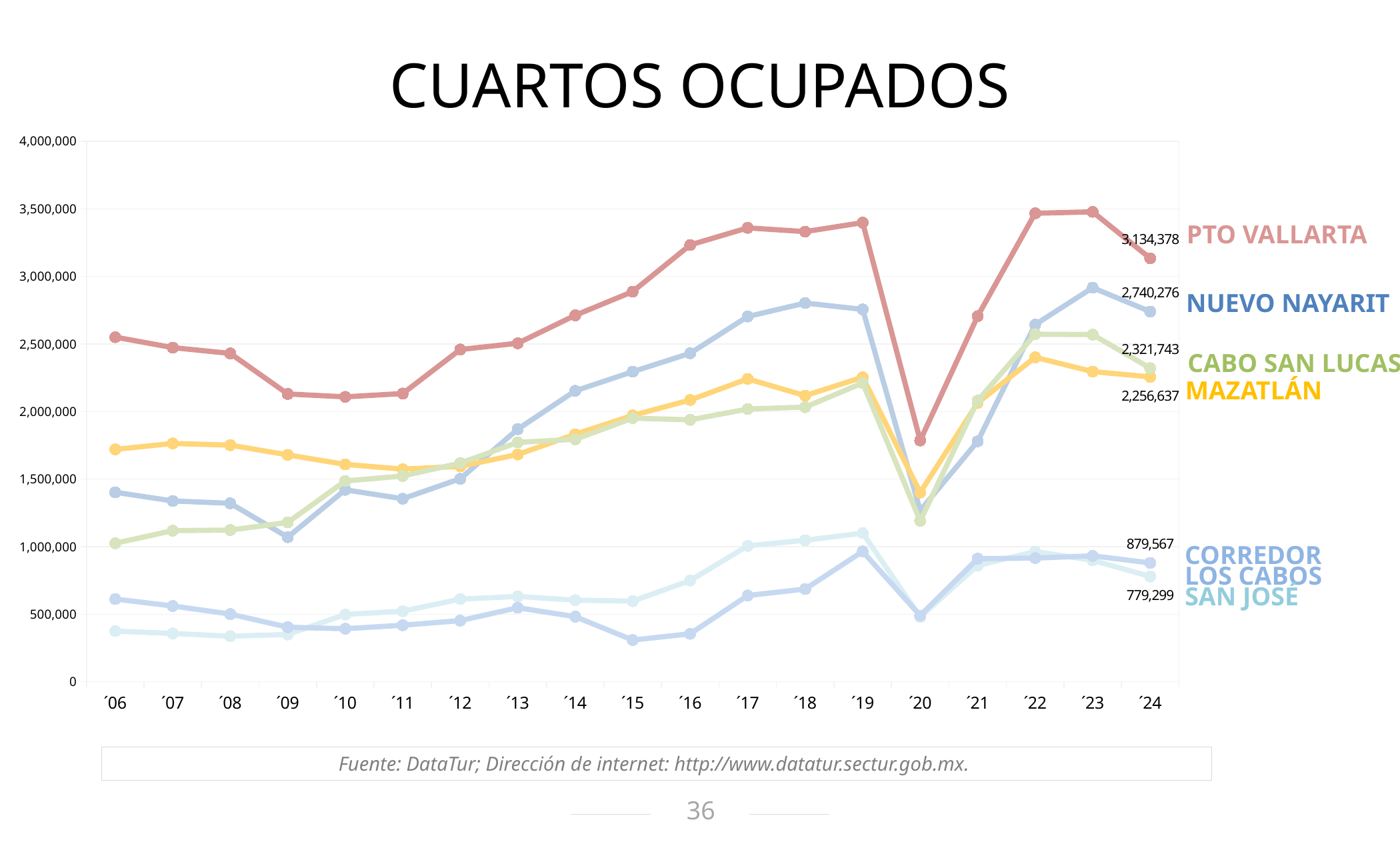
Is the value for PTO VALLARTA in ´20 greater or less than 2,000,000? less What kind of chart is shown on the slide? Line chart What is the value for CABO SAN LUCAS in ´24? 2,321,743 Which series has the highest value in ´24? PTO VALLARTA What is the value for MAZATLÁN in ´24? 2,256,637 What is the value for SAN JOSÉ in ´24? 779,299 Which series has the lowest value in ´24? SAN JOSÉ What is the value for NUEVO NAYARIT in ´24? 2,740,276 What is the difference between CORREDOR LOS CABOS and SAN JOSÉ in ´24? 100,268 How many years are shown on the x axis? 19 What is the value for PTO VALLARTA in ´24? 3,134,378 What is the difference between PTO VALLARTA and NUEVO NAYARIT in ´24? 394,102